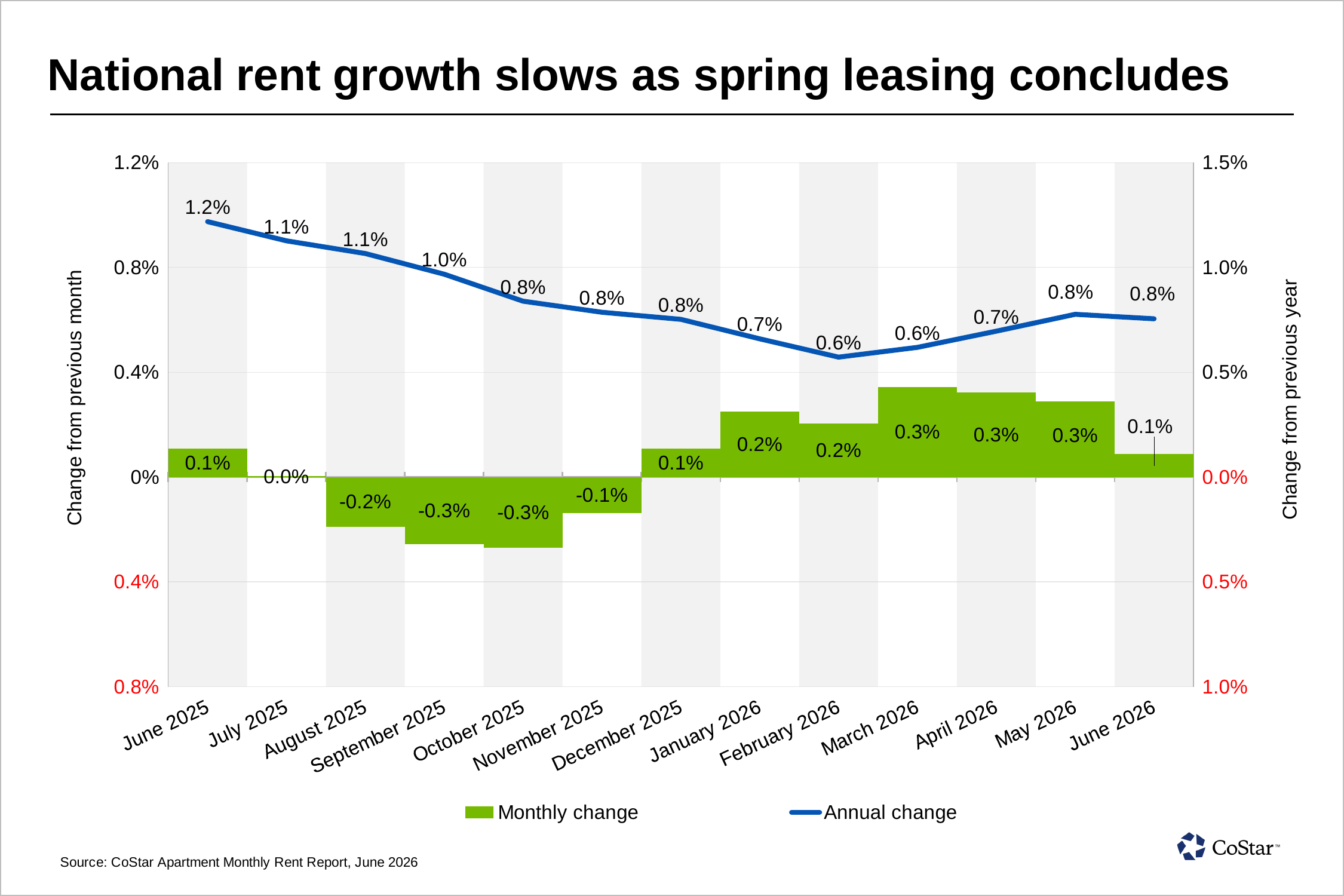
How many months are shown on the x axis? 13 What is the annual change in rent for June 2026? 0.8% What is the monthly change in rent for March 2026? 0.3% In which month is the annual change highest? June 2025 What is the monthly change in rent for September 2025? -0.3% By how many percentage points did the annual change fall from June 2025 to June 2026? 0.4 percentage points What is the monthly change in rent for July 2025? 0.0% Does the annual change rise or fall from June 2025 to February 2026? Fall Which is larger, the monthly change in January 2026 or the monthly change in November 2025? January 2026 What kind of chart is shown on the slide? Combination bar and line chart How many series does the legend list? 2 What is the annual change in rent for June 2025? 1.2%